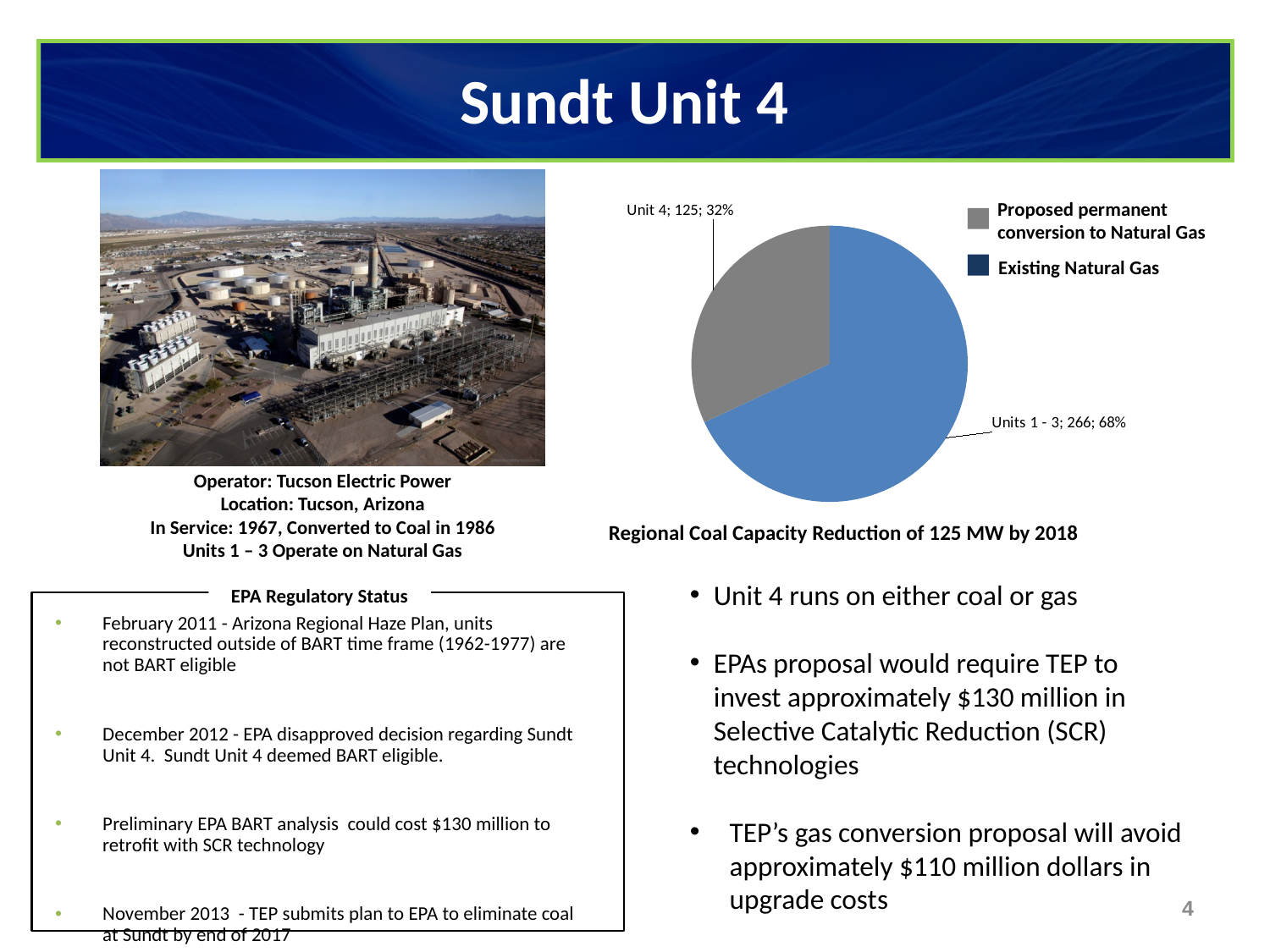
Which slice of the pie chart is the largest? Units 1 - 3 What is the value for Units 1 - 3 in the pie chart? 266 Which legend entry is shown in gray in the pie chart? Proposed permanent conversion to Natural Gas What is the difference between the values for Units 1 - 3 and Unit 4? 141 What share of the pie do Units 1 - 3 represent? 68% What kind of chart is shown on the slide? pie chart Which is larger, the value for Unit 4 or the value for Units 1 - 3? Units 1 - 3 How many slices does the pie chart have? 2 How many entries does the pie chart's legend list? 2 What share of the pie does Unit 4 represent? 32% Which slice of the pie chart is the smallest? Unit 4 What is the value for Unit 4 in the pie chart? 125